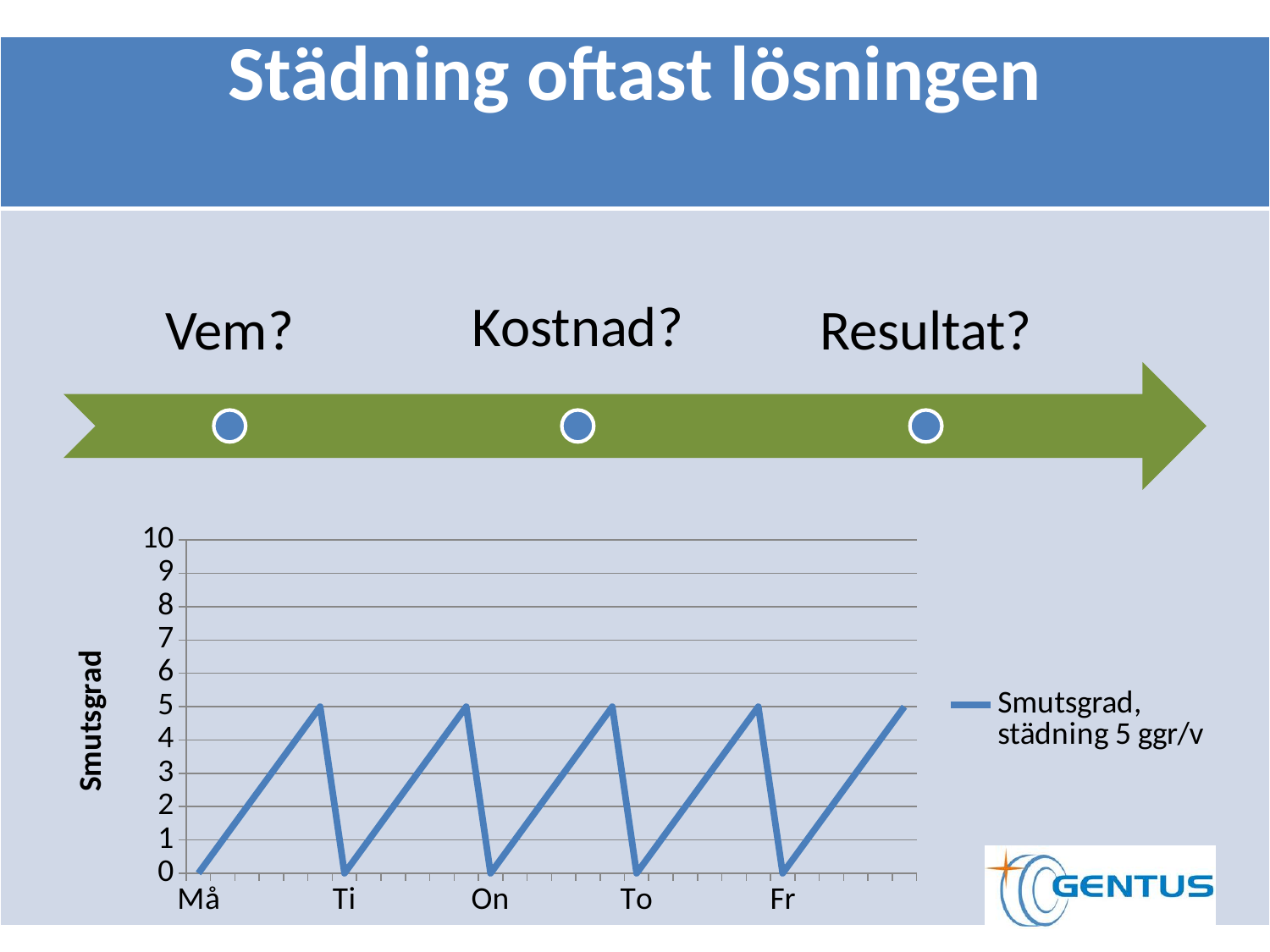
How many series does the legend list? 1 What is the title of the vertical axis of the chart? Smutsgrad What is the highest value the line reaches in the chart? 5 What kind of chart is shown on the slide? line chart Is the peak value of the line greater or less than 8? less What is the legend entry for the series in the chart? Smutsgrad, städning 5 ggr/v How many day labels are shown on the x axis of the chart? 5 What is the highest value shown on the vertical axis of the chart? 10 What is the difference between the peak value and the value at On? 5 What is the lowest value the line reaches in the chart? 0 What is the value of the line at Må? 0 What is the value of the line at Ti? 0